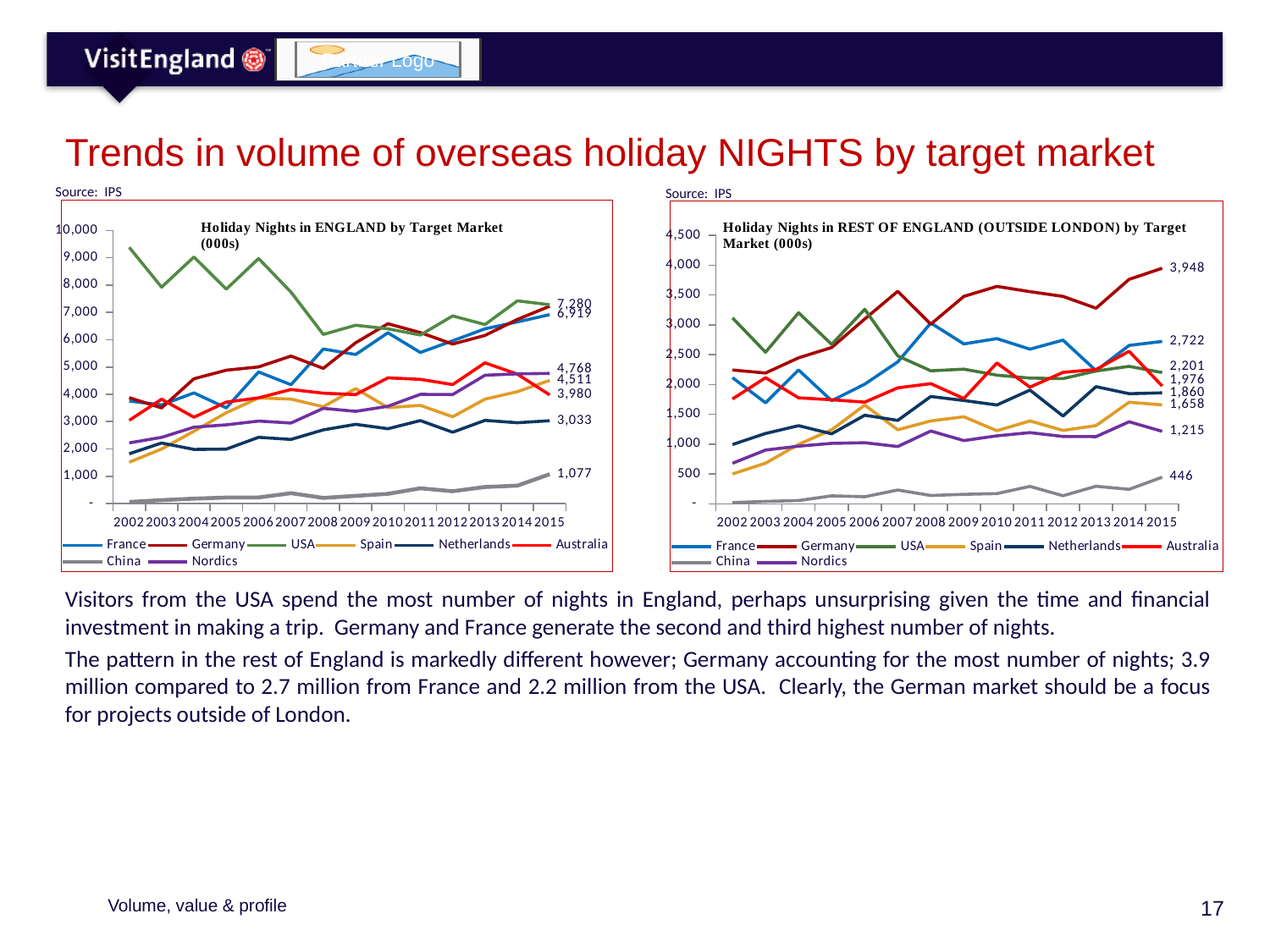
In the 'Holiday Nights in ENGLAND by Target Market (000s)' chart, does the USA line rise or fall overall from 2002 to 2015? Fall How many years are plotted along the x axis of the 'Holiday Nights in ENGLAND by Target Market (000s)' chart? 14 In the 'Holiday Nights in ENGLAND by Target Market (000s)' chart, is the value for Germany in 2002 greater or less than 5,000? less In the 'Holiday Nights in REST OF ENGLAND (OUTSIDE LONDON)' chart, what is the value for Germany in 2015? 3,948 In the 'Holiday Nights in REST OF ENGLAND (OUTSIDE LONDON)' chart, what is the difference between Germany and France in 2015? 1,226 How many series does the legend of the 'Holiday Nights in REST OF ENGLAND (OUTSIDE LONDON)' chart list? 8 In the 'Holiday Nights in REST OF ENGLAND (OUTSIDE LONDON)' chart, which market has the lowest value in 2015? China In the 'Holiday Nights in ENGLAND by Target Market (000s)' chart, what is the value for China in 2015? 1,077 What type of chart is the 'Holiday Nights in ENGLAND by Target Market (000s)' chart? Line chart In the 'Holiday Nights in REST OF ENGLAND (OUTSIDE LONDON)' chart, what is the value for France in 2015? 2,722 In the 'Holiday Nights in REST OF ENGLAND (OUTSIDE LONDON)' chart, which market has the highest value in 2015? Germany In the 'Holiday Nights in REST OF ENGLAND (OUTSIDE LONDON)' chart, what is the value for the USA in 2015? 2,201